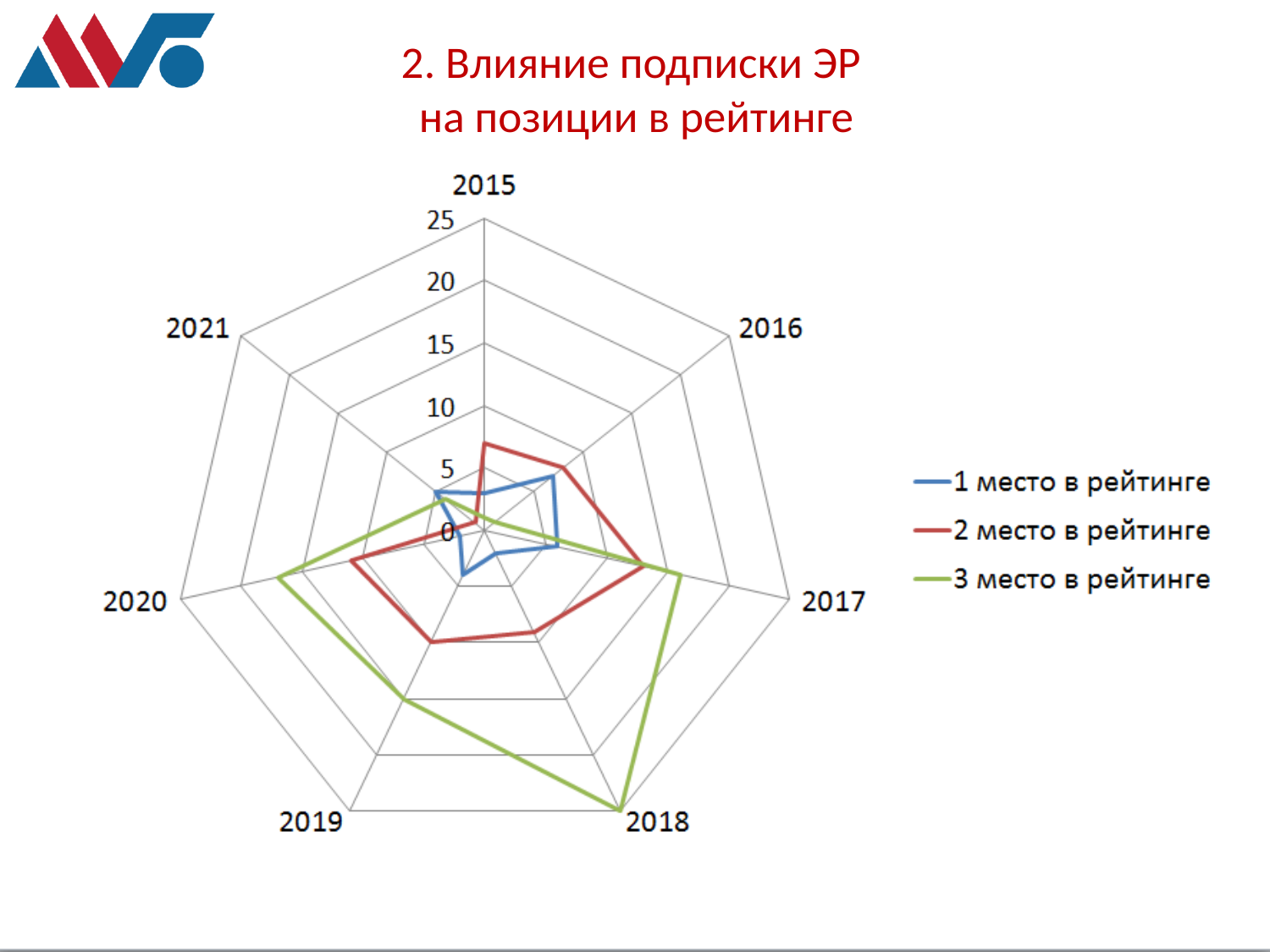
Which year has the highest value for the series '2 место в рейтинге'? 2017 Is the value for '2 место в рейтинге' in 2017 greater or less than 10? greater Is the value for '3 место в рейтинге' in 2018 greater or less than 20? greater How many categories (years) are plotted on the chart? 7 In 2016, which series has the larger value: '2 место в рейтинге' or '1 место в рейтинге'? 2 место в рейтинге How many series does the legend list? 3 Is the value for '3 место в рейтинге' in 2020 greater or less than 15? greater In 2018, which series has the larger value: '3 место в рейтинге' or '2 место в рейтинге'? 3 место в рейтинге Which series is drawn in green according to the legend? 3 место в рейтинге What kind of chart is shown on the slide? radar chart Which year has the highest value for the series '3 место в рейтинге'? 2018